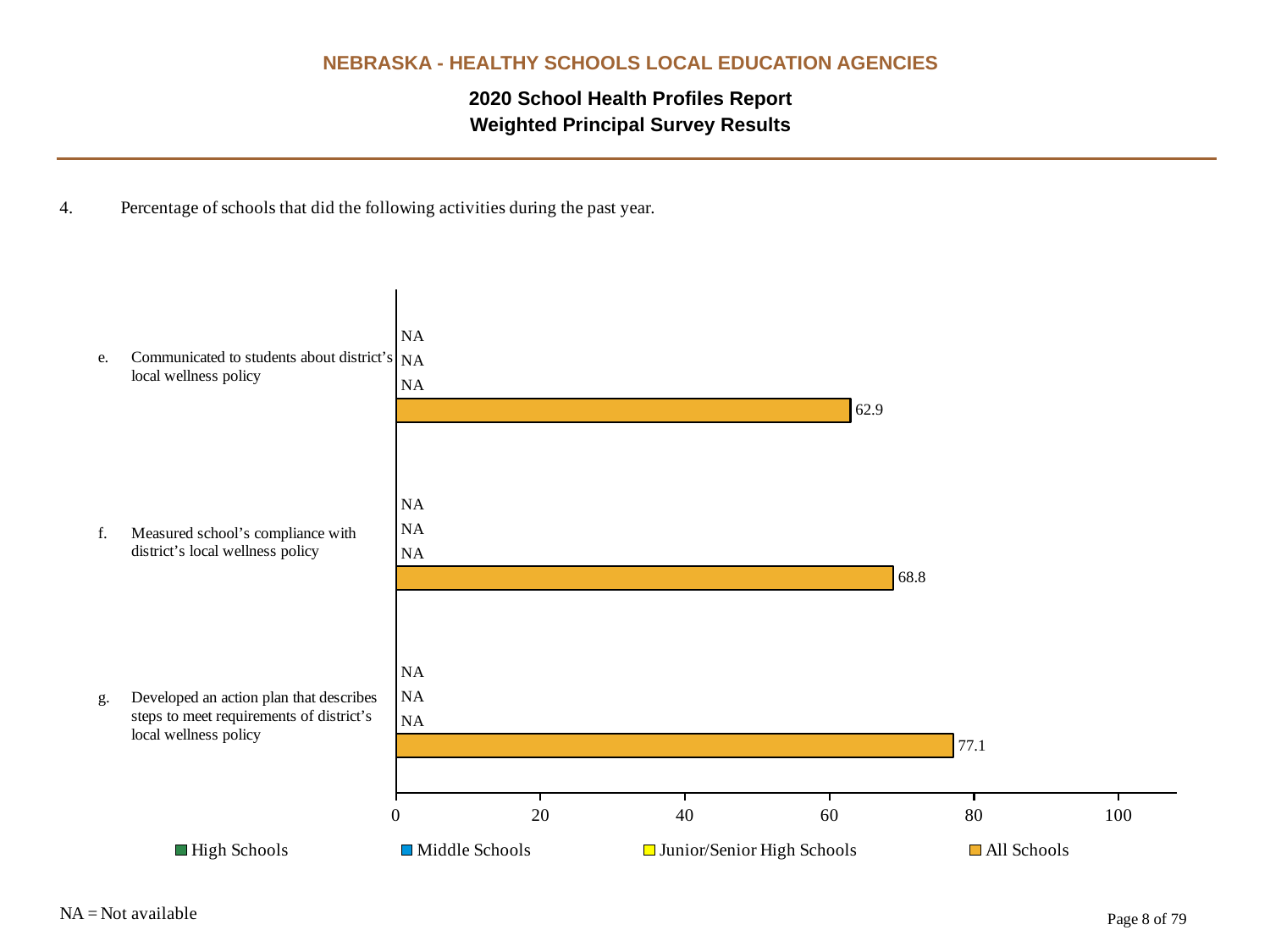
How many series does the legend list? 4 Is the All Schools value for 'Measured school's compliance with district's local wellness policy' greater or less than 60? greater What is the All Schools value for 'Communicated to students about district's local wellness policy'? 62.9 What is the difference between the All Schools values for 'Developed an action plan' and 'Communicated to students about district's local wellness policy'? 14.2 Which activity has the lowest All Schools percentage? Communicated to students about district's local wellness policy What is the All Schools value for 'Developed an action plan that describes steps to meet requirements of district's local wellness policy'? 77.1 How many activities (categories) are shown on the chart? 3 What is the All Schools value for 'Measured school's compliance with district's local wellness policy'? 68.8 Which activity has the highest All Schools percentage? Developed an action plan that describes steps to meet requirements of district's local wellness policy What value is shown for High Schools, Middle Schools and Junior/Senior High Schools for each activity? NA What kind of chart is shown on the slide? Bar chart Which is larger for All Schools: 'Measured school's compliance with district's local wellness policy' or 'Communicated to students about district's local wellness policy'? Measured school's compliance with district's local wellness policy